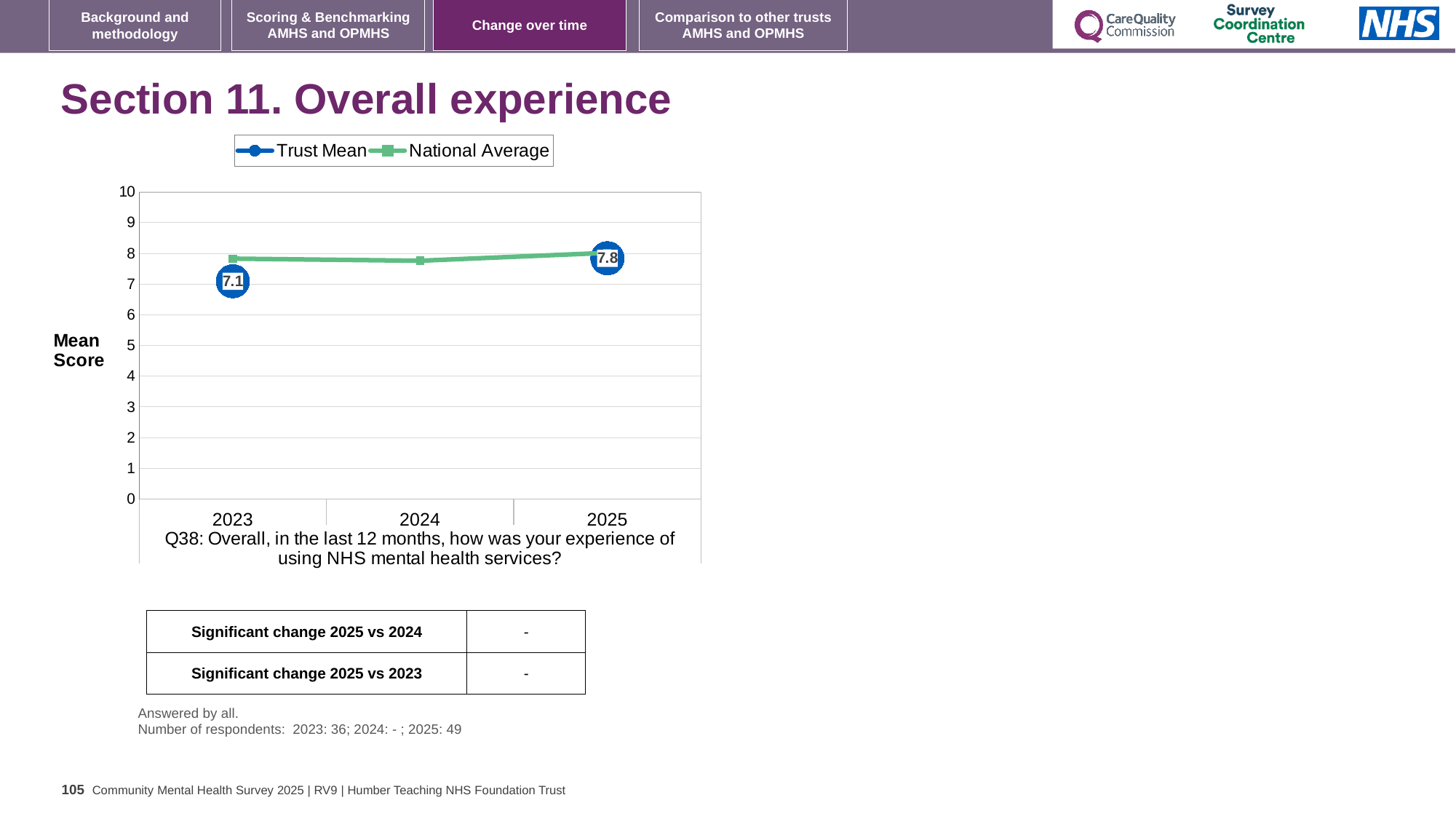
What type of chart is shown on the slide? Line chart What is the label on the y axis of the chart? Mean Score How many series does the chart legend list? 2 Does the Trust Mean rise or fall between 2023 and 2025? Rise What is the Trust Mean score for 2023? 7.1 In 2023, which is higher: the Trust Mean or the National Average? National Average Is the National Average value for 2024 greater or less than 7? greater Is the Trust Mean value for 2023 greater or less than 8? less What is the Trust Mean score for 2025? 7.8 By how much did the Trust Mean score change from 2023 to 2025? 0.7 How many years are shown on the x axis of the chart? 3 Which year has the higher Trust Mean score, 2023 or 2025? 2025